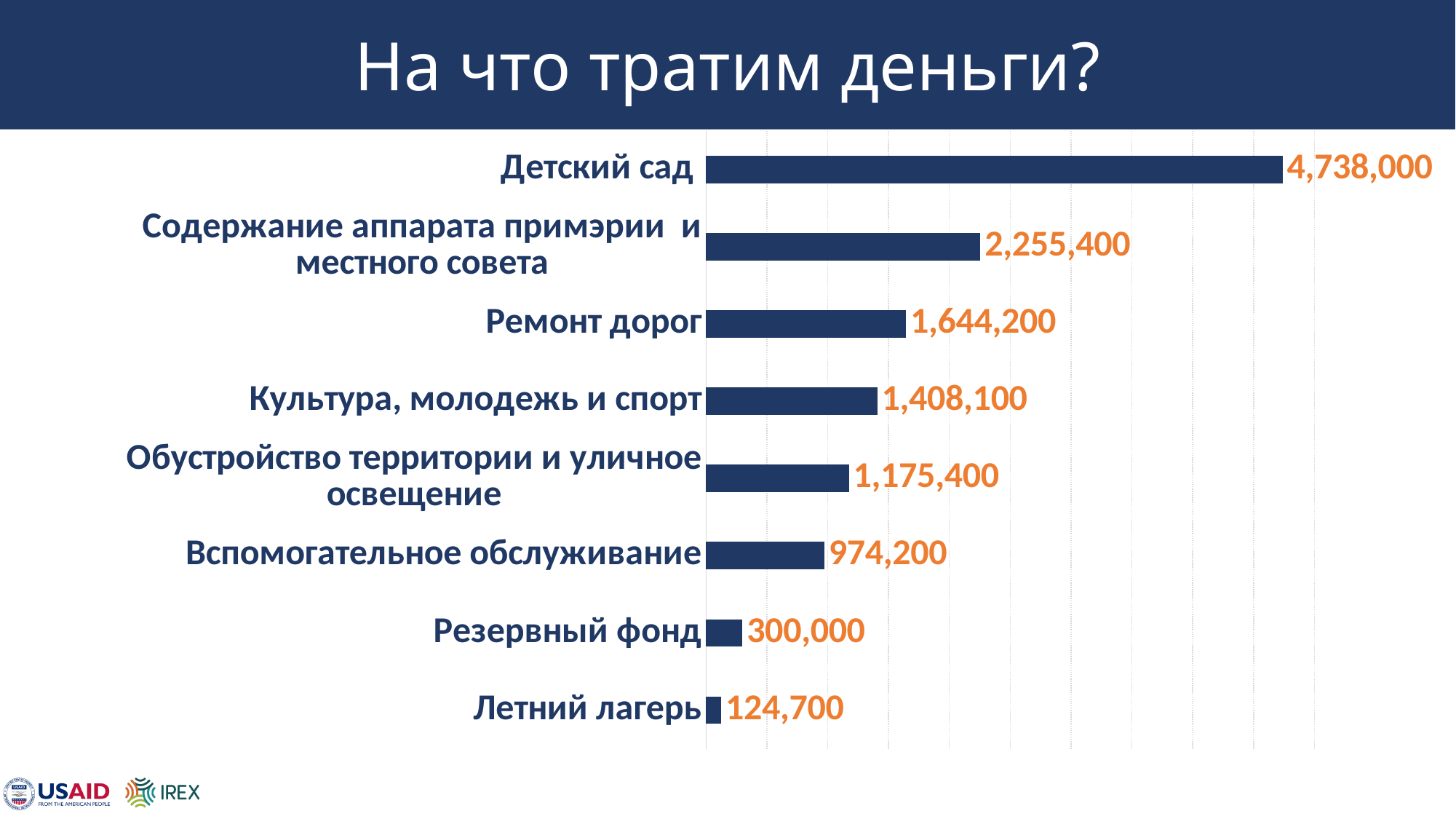
What is the title of the slide? На что тратим деньги? What is the value for Детский сад? 4,738,000 What kind of chart is shown on the slide? Bar chart Which category has the highest value? Детский сад What is the difference between the values for Резервный фонд and Летний лагерь? 175,300 Which category has the lowest value? Летний лагерь What is the value for Вспомогательное обслуживание? 974,200 Which is larger, the value for Культура, молодежь и спорт or the value for Обустройство территории и уличное освещение? Культура, молодежь и спорт What is the value for Летний лагерь? 124,700 How many categories are shown in the chart? 8 What is the value for Ремонт дорог? 1,644,200 What is the difference between the values for Детский сад and Содержание аппарата примэрии и местного совета? 2,482,600